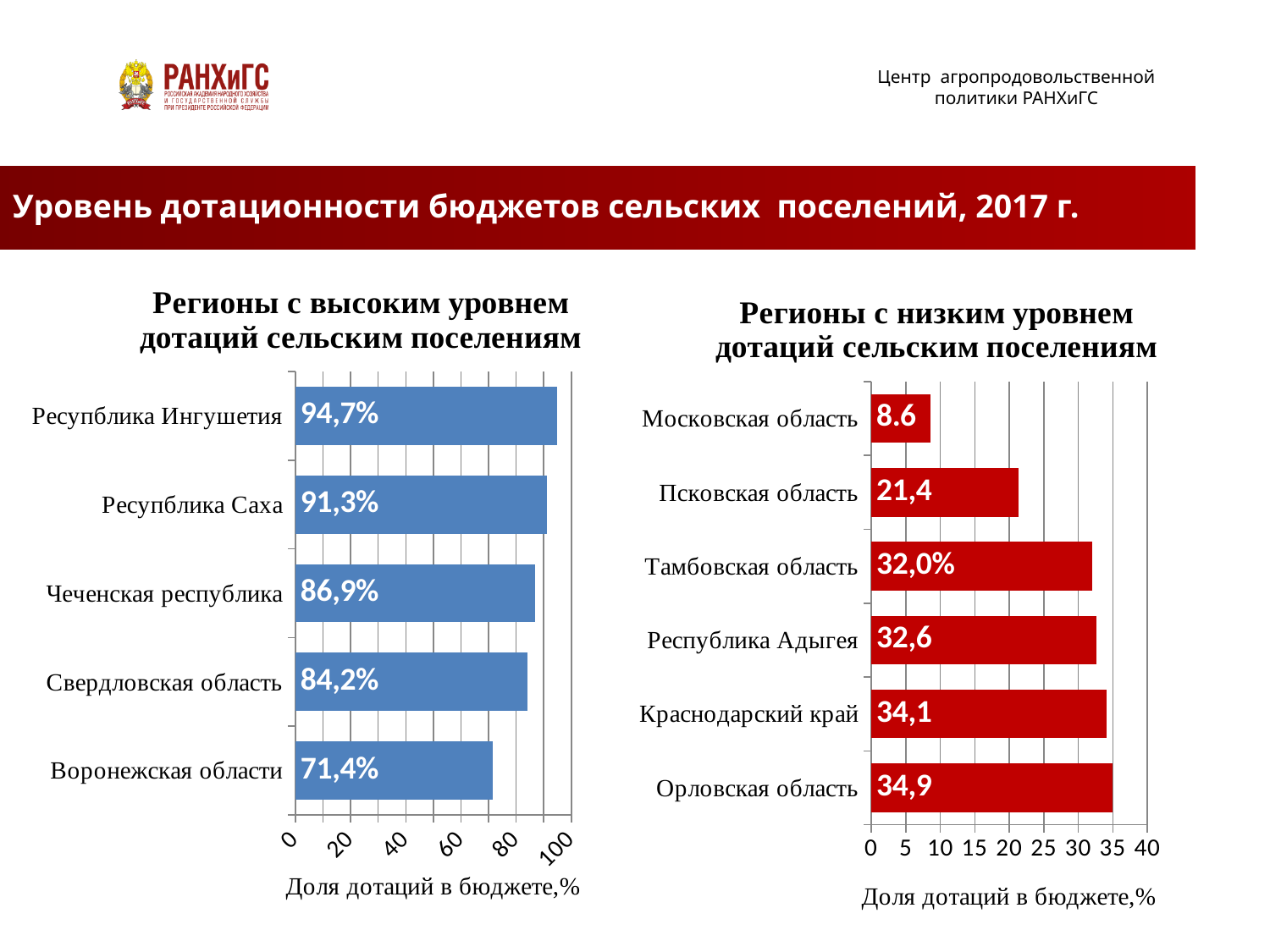
In the chart 'Регионы с высоким уровнем дотаций сельским поселениям', what is the value for Ресупблика Ингушетия? 94,7% In the chart 'Регионы с низким уровнем дотаций сельским поселениям', what is the value for Московская область? 8.6 In the chart 'Регионы с высоким уровнем дотаций сельским поселениям', what is the value for Свердловская область? 84,2% In the chart 'Регионы с низким уровнем дотаций сельским поселениям', which is larger: Псковская область or Краснодарский край? Краснодарский край What is the x-axis label of the chart 'Регионы с высоким уровнем дотаций сельским поселениям'? Доля дотаций в бюджете,% What type of chart is 'Регионы с низким уровнем дотаций сельским поселениям'? Bar chart In the chart 'Регионы с низким уровнем дотаций сельским поселениям', which region has the highest value? Орловская область In the chart 'Регионы с низким уровнем дотаций сельским поселениям', how many regions are shown? 6 In the chart 'Регионы с высоким уровнем дотаций сельским поселениям', which region has the lowest value? Воронежская области In the chart 'Регионы с высоким уровнем дотаций сельским поселениям', what is the difference between Ресупблика Саха and Чеченская республика? 4,4% In the chart 'Регионы с низким уровнем дотаций сельским поселениям', what is the value for Тамбовская область? 32,0% In the chart 'Регионы с высоким уровнем дотаций сельским поселениям', how many regions are shown? 5